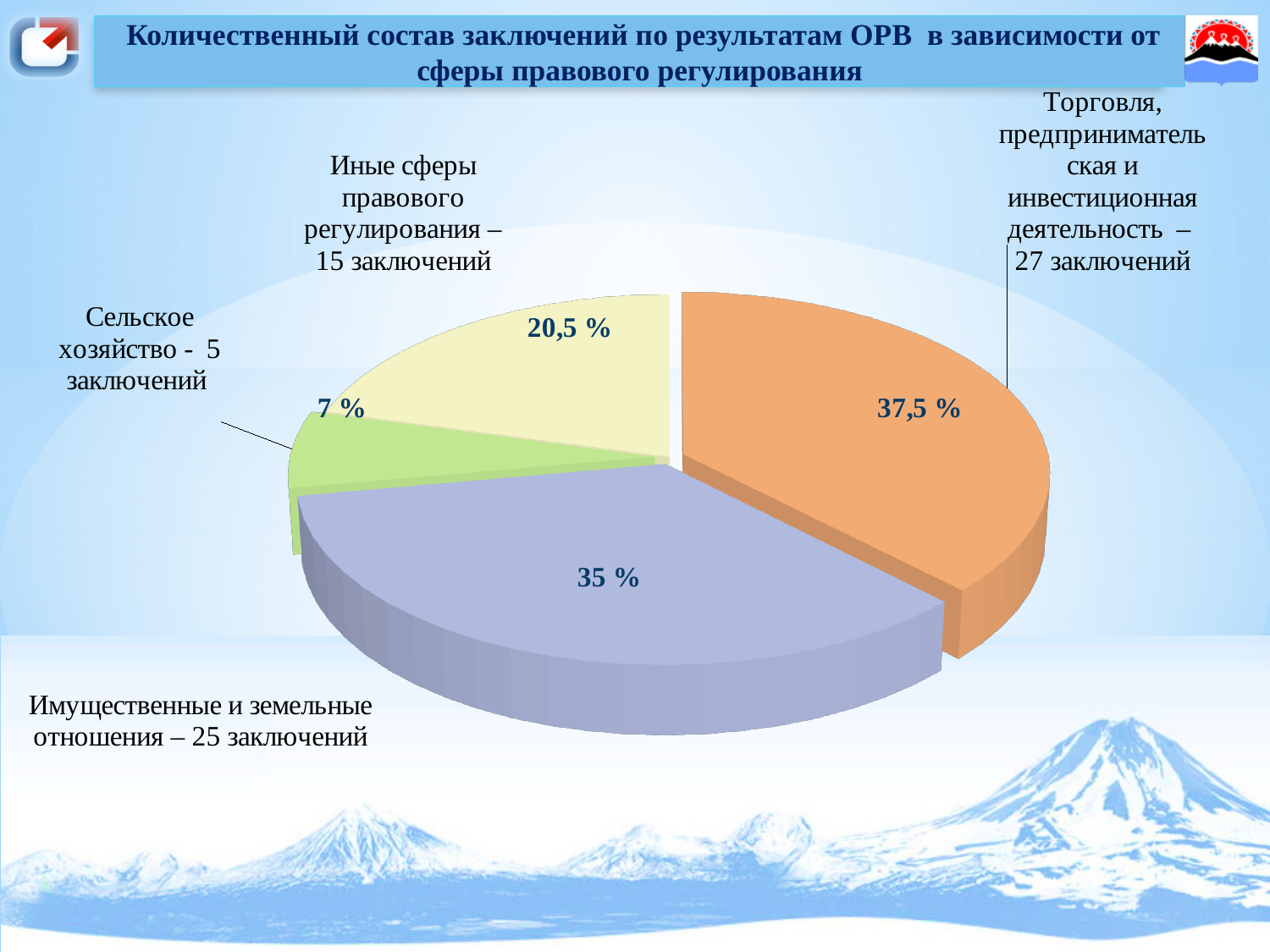
Which category has the smallest slice of the pie? Сельское хозяйство What percentage share is shown for the slice "Иные сферы правового регулирования"? 20,5 % What kind of chart is shown on the slide? Pie chart What colour is the slice for "Имущественные и земельные отношения"? Blue-purple (lavender) What percentage share is shown for the slice "Сельское хозяйство"? 7 % How many заключений are attributed to "Торговля, предпринимательская и инвестиционная деятельность"? 27 заключений What is the difference in the number of заключений between "Имущественные и земельные отношения" and "Иные сферы правового регулирования"? 10 How many заключений are attributed to "Сельское хозяйство"? 5 заключений How many slices does the pie chart have? 4 Which category has the largest slice of the pie? Торговля, предпринимательская и инвестиционная деятельность What percentage share is shown for the slice "Торговля, предпринимательская и инвестиционная деятельность"? 37,5 %